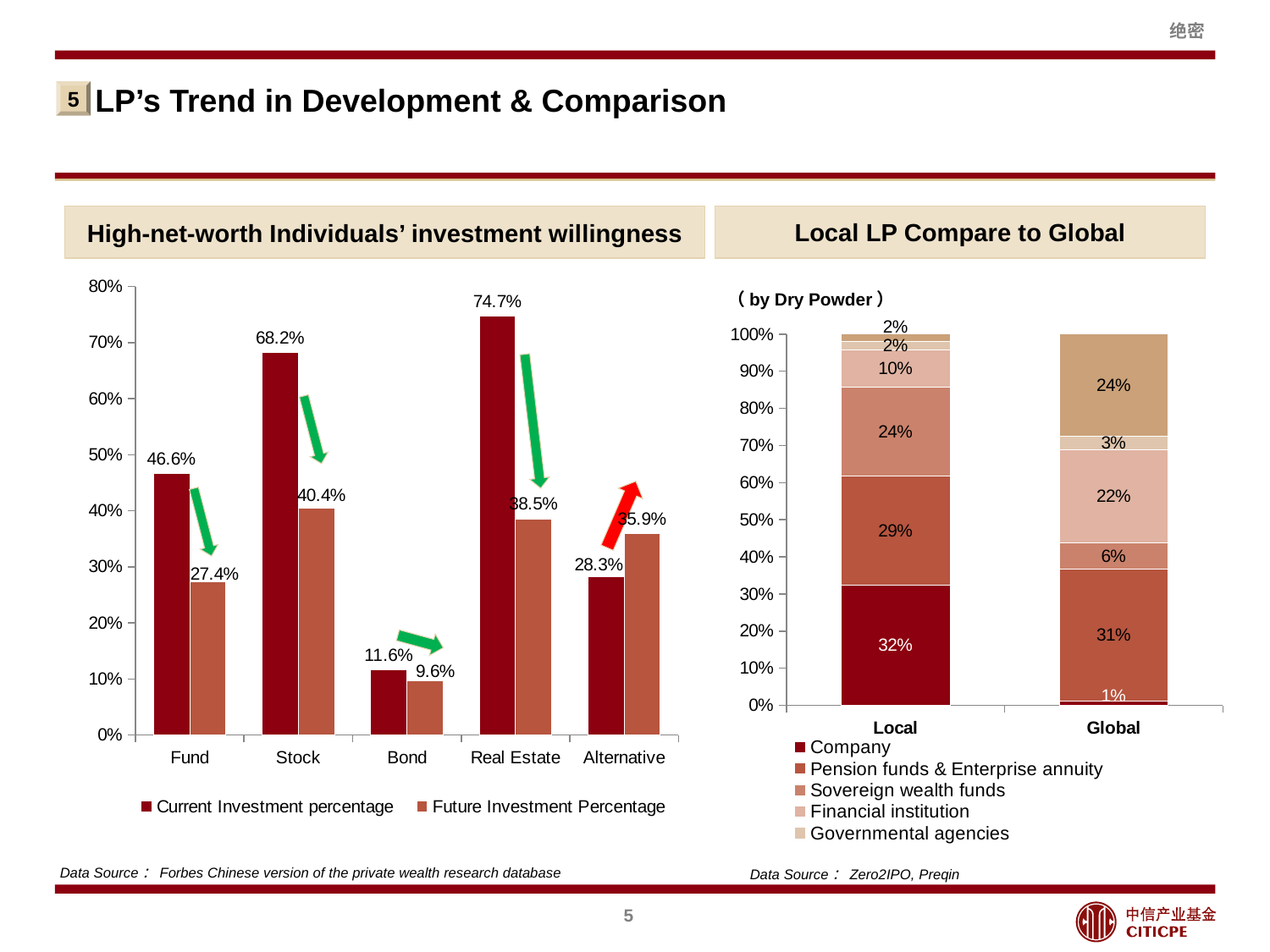
In the 'Local LP Compare to Global' chart, what share of the Global bar is Financial institution? 22% In the 'High-net-worth Individuals' investment willingness' chart, what is the Future Investment Percentage for Stock? 40.4% In the 'Local LP Compare to Global' chart, what share of the Local bar is Company? 32% How many series does the legend of the 'Local LP Compare to Global' chart list? 5 In the 'High-net-worth Individuals' investment willingness' chart, which is larger for Alternative: the Current Investment percentage or the Future Investment Percentage? Future Investment Percentage In the 'High-net-worth Individuals' investment willingness' chart, what is the Current Investment percentage for Real Estate? 74.7% In the 'Local LP Compare to Global' chart, which bar has the larger Sovereign wealth funds share, Local or Global? Local How many categories are shown on the x axis of the 'High-net-worth Individuals' investment willingness' chart? 5 In the 'High-net-worth Individuals' investment willingness' chart, which category has the lowest Future Investment Percentage? Bond In the 'High-net-worth Individuals' investment willingness' chart, which category has the highest Current Investment percentage? Real Estate What kind of chart is the 'High-net-worth Individuals' investment willingness' chart? Bar chart In the 'High-net-worth Individuals' investment willingness' chart, what is the difference between the Current and Future investment percentages for Fund? 19.2%